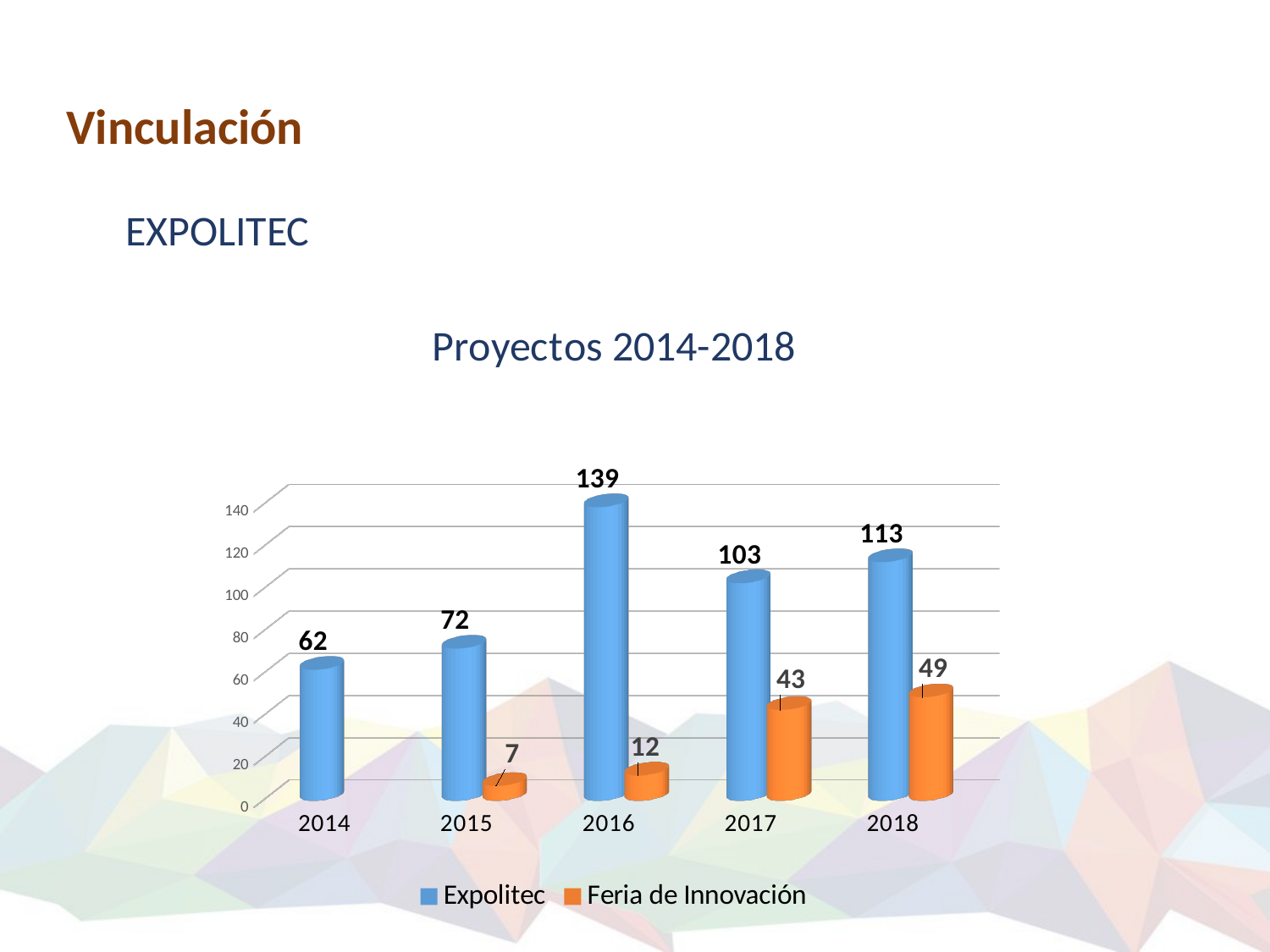
What kind of chart is shown? bar chart What is the Expolitec value for 2014? 62 Is the Expolitec value for 2017 greater or less than 100? greater How many series does the legend list? 2 Which is larger, the Expolitec value for 2015 or the Expolitec value for 2018? 2018 Which year has the highest Expolitec value? 2016 What is the Expolitec value for 2016? 139 Which year has the lowest Feria de Innovación value among those shown? 2015 How many years are shown on the x axis? 5 What is the Feria de Innovación value for 2017? 43 What is the title of the chart? Proyectos 2014-2018 What is the difference between the Expolitec values for 2016 and 2017? 36